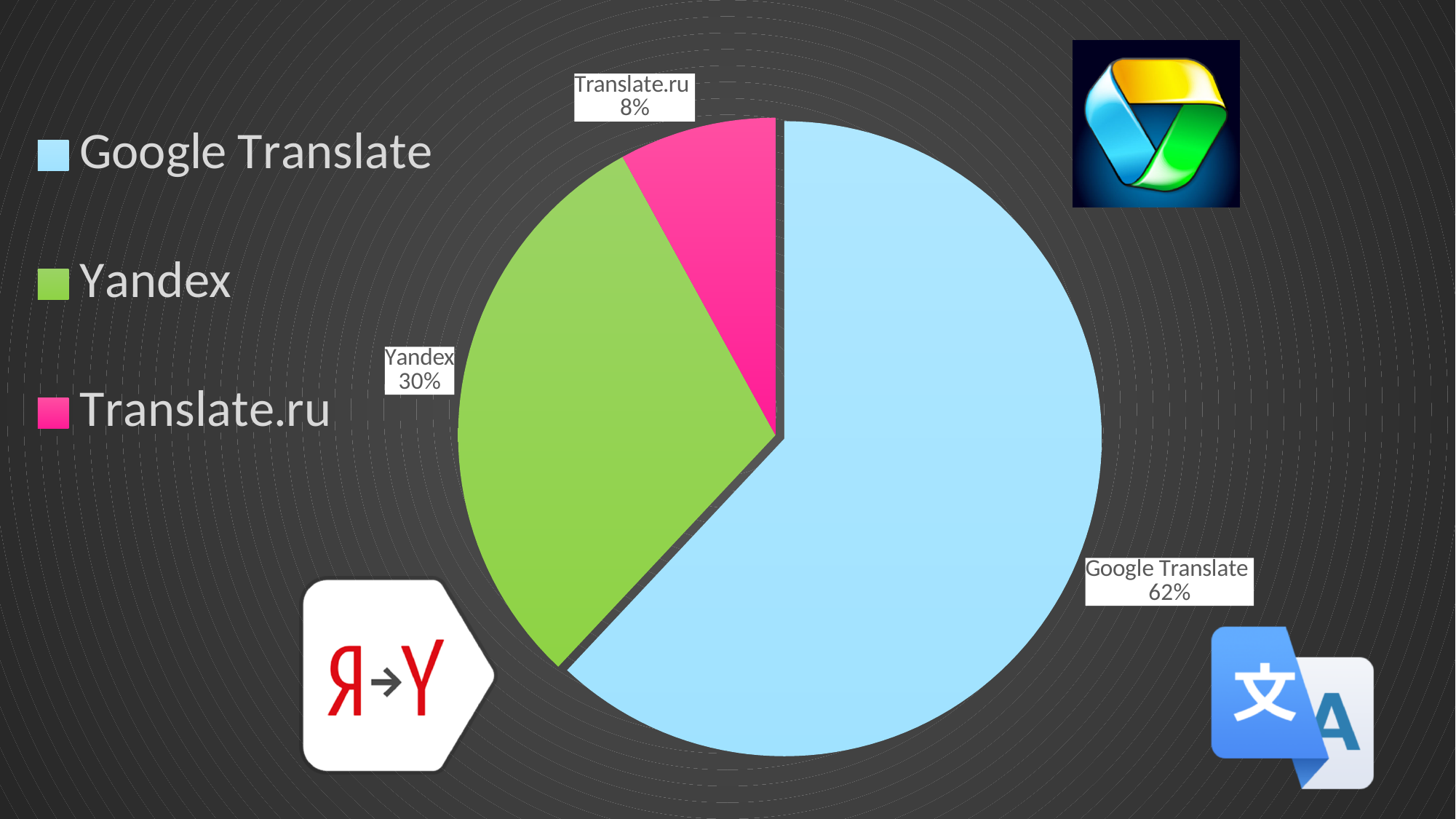
Which slice of the pie is the largest? Google Translate What share of the pie does Translate.ru have? 8% What share of the pie does Yandex have? 30% How many entries does the legend list? 3 What is the difference in percentage points between Yandex and Translate.ru? 22 What is the difference in percentage points between Google Translate and Yandex? 32 Which is larger, the Yandex slice or the Translate.ru slice? Yandex What kind of chart is shown on the slide? pie chart What share of the pie does Google Translate have? 62% How many slices does the pie chart have? 3 Which slice of the pie is the smallest? Translate.ru What colour is the Yandex slice in the pie chart? green